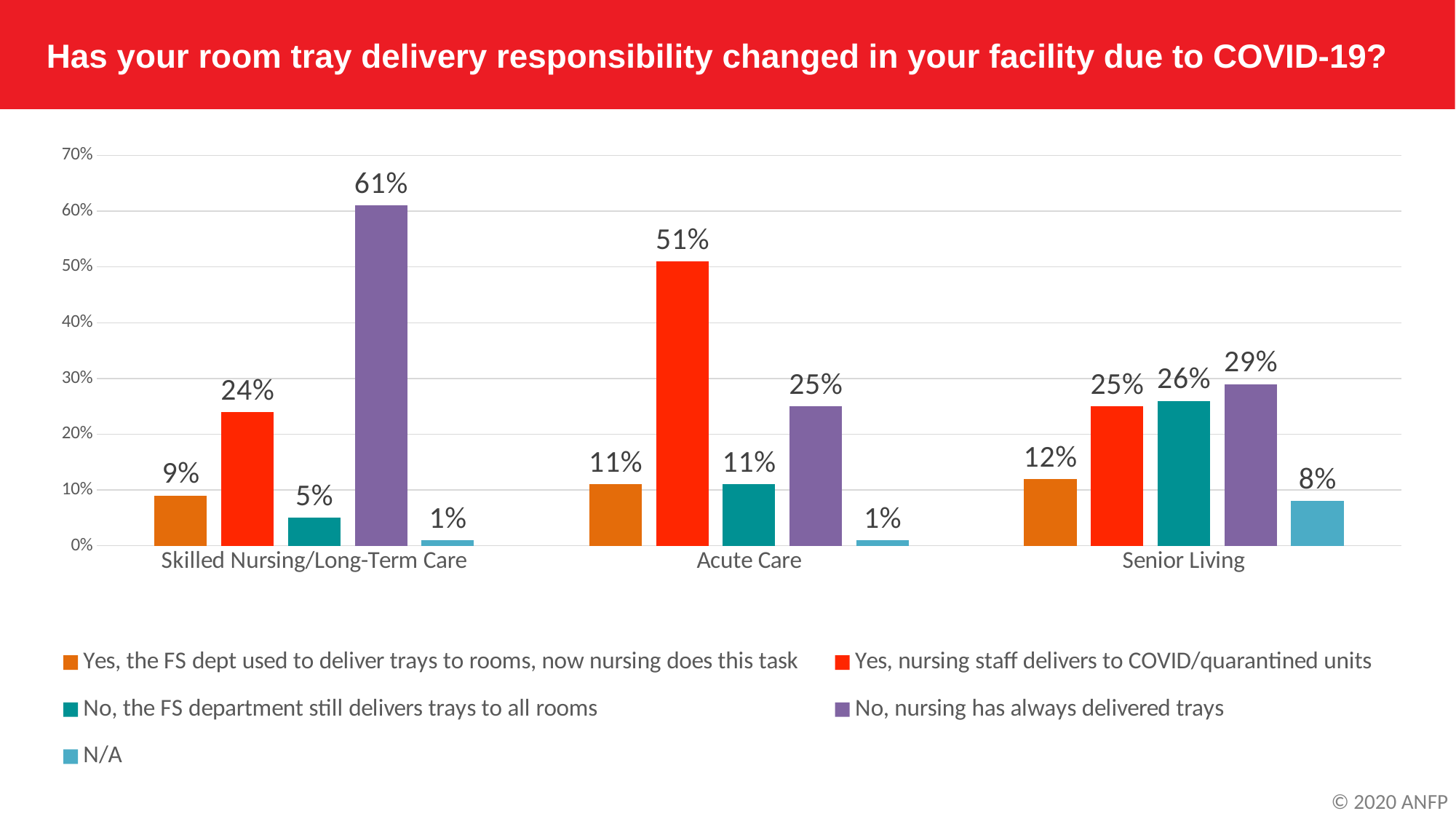
What is the N/A value for Senior Living? 8% How many series does the legend list? 5 How many facility types are shown on the x axis? 3 What is the title of the chart? Has your room tray delivery responsibility changed in your facility due to COVID-19? Which is larger for Senior Living: "Yes, the FS dept used to deliver trays to rooms, now nursing does this task" or "Yes, nursing staff delivers to COVID/quarantined units"? Yes, nursing staff delivers to COVID/quarantined units What percentage of Skilled Nursing/Long-Term Care respondents answered "No, nursing has always delivered trays"? 61% What percentage of Acute Care respondents answered "Yes, nursing staff delivers to COVID/quarantined units"? 51% What is the difference between the "No, nursing has always delivered trays" values for Skilled Nursing/Long-Term Care and Senior Living? 32% What colour are the bars for "No, nursing has always delivered trays"? Purple Which facility type has the highest value for "No, the FS department still delivers trays to all rooms"? Senior Living Which response has the lowest value for Acute Care? N/A What kind of chart is shown on the slide? Bar chart